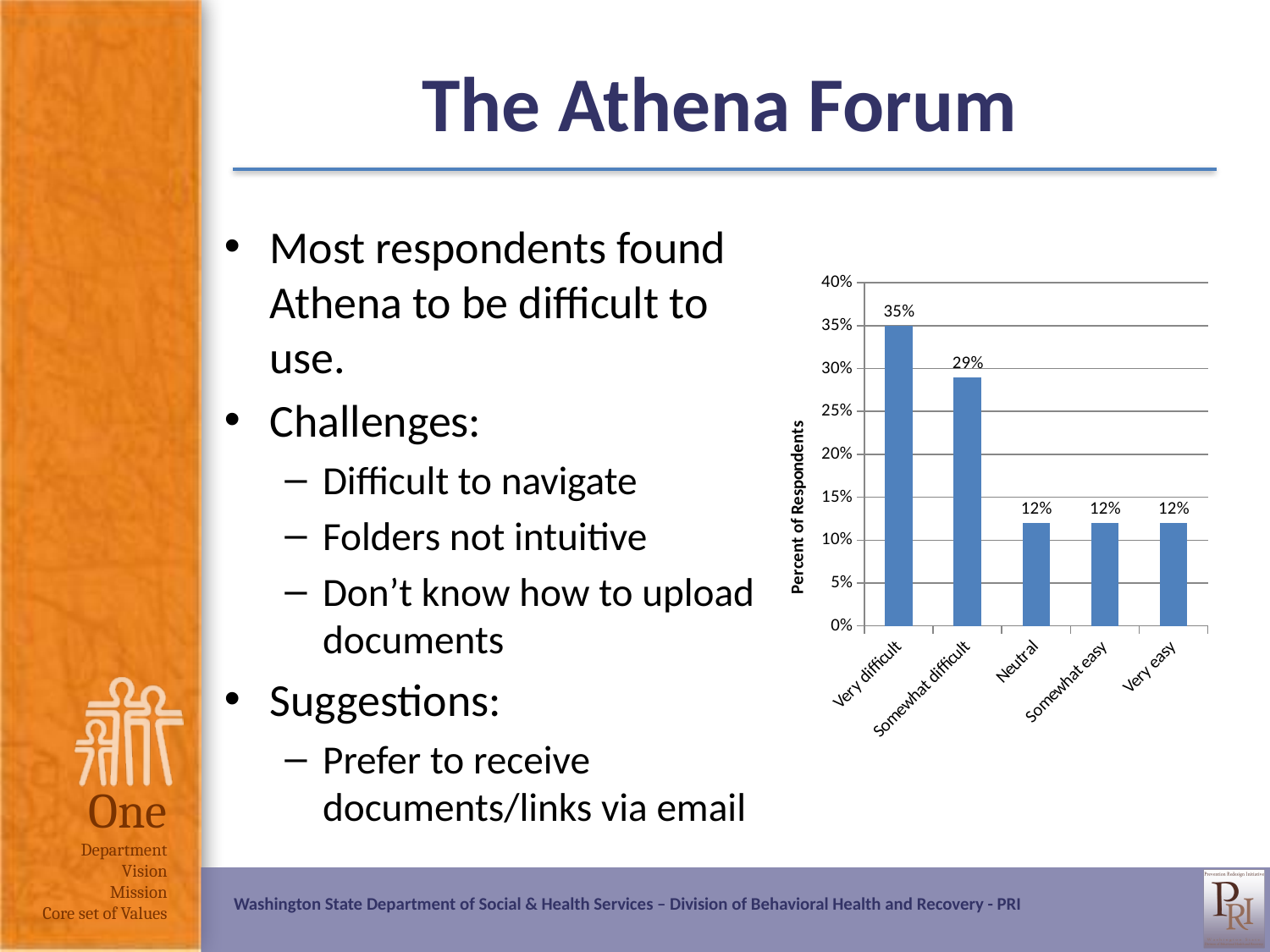
What percentage of respondents rated the Athena Forum as somewhat difficult? 29% What is the highest value shown on the vertical axis of the chart? 40% Is the value for 'Somewhat difficult' greater or less than 25%? greater What percentage of respondents found the Athena Forum very difficult? 35% Which is larger, the value for 'Very difficult' or the value for 'Neutral'? Very difficult What kind of chart is shown on the slide? Bar chart How many categories are shown on the x axis of the chart? 5 What percentage of respondents were neutral about the Athena Forum? 12% What is the difference in percentage points between the 'Very difficult' and 'Somewhat difficult' categories? 6% What is the label of the vertical axis of the chart? Percent of Respondents Which category has the highest percentage of respondents? Very difficult What is the difference between the 'Somewhat difficult' and 'Very easy' percentages? 17%